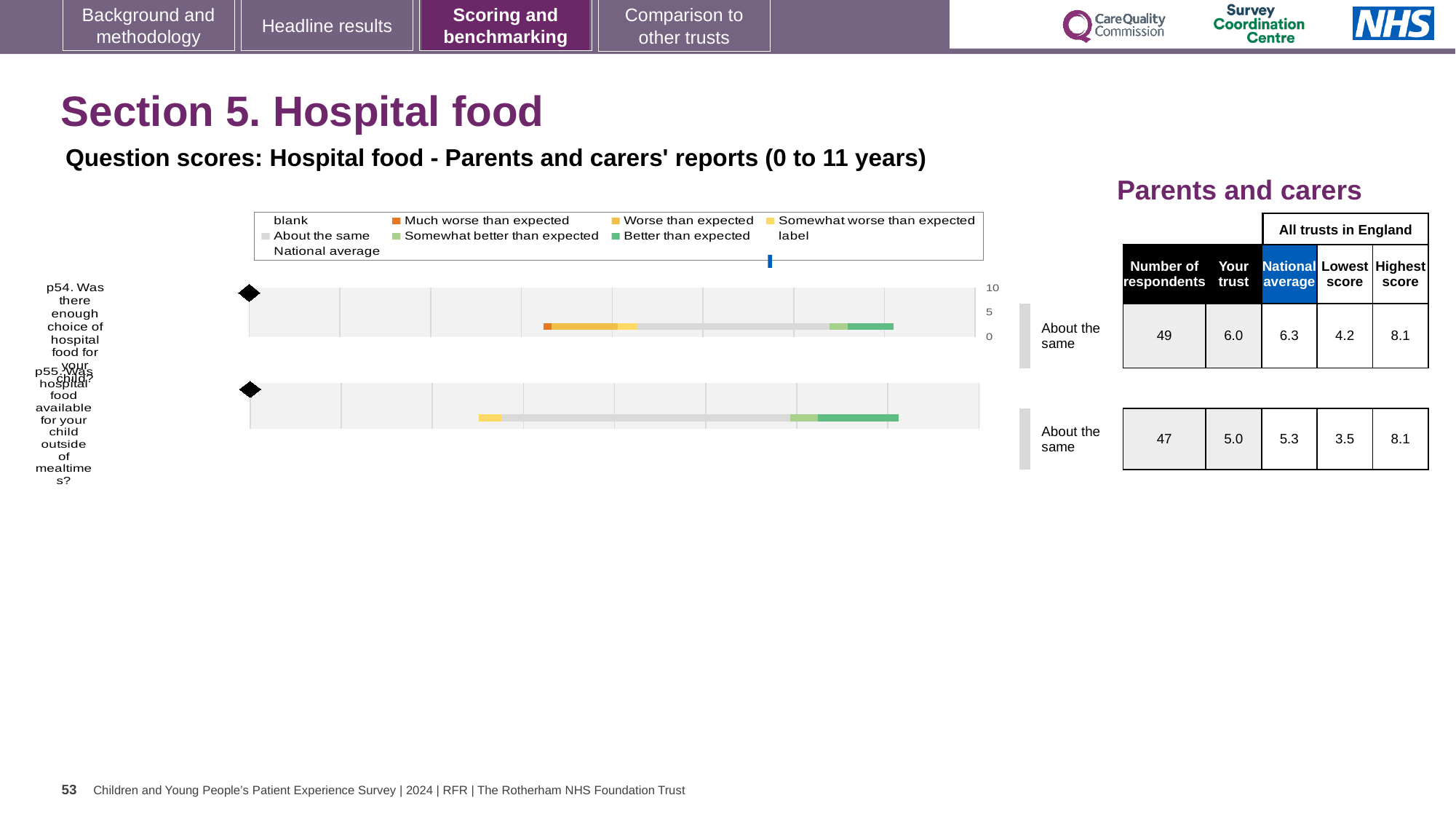
Which question has the higher 'Your trust' score, p54 or p55? p54 What is the highest score among all trusts in England for p55? 8.1 What kind of chart is used to show the question scores for hospital food? bar chart What is the difference between the national average and the 'Your trust' score for p54? 0.3 What benchmark category is shown for p55 next to the chart? About the same How many respondents answered p54 according to the table beside the chart? 49 According to the table beside the chart, what is the national average for p55 (hospital food available outside of mealtimes)? 5.3 According to the table beside the chart, what is the 'Your trust' score for p54 (enough choice of hospital food)? 6.0 What is the lowest score among all trusts in England for p54? 4.2 What is the maximum value shown on the chart's score axis? 10 What is the difference between the highest and lowest scores for p55? 4.6 How many survey questions are plotted in the hospital food chart? 2